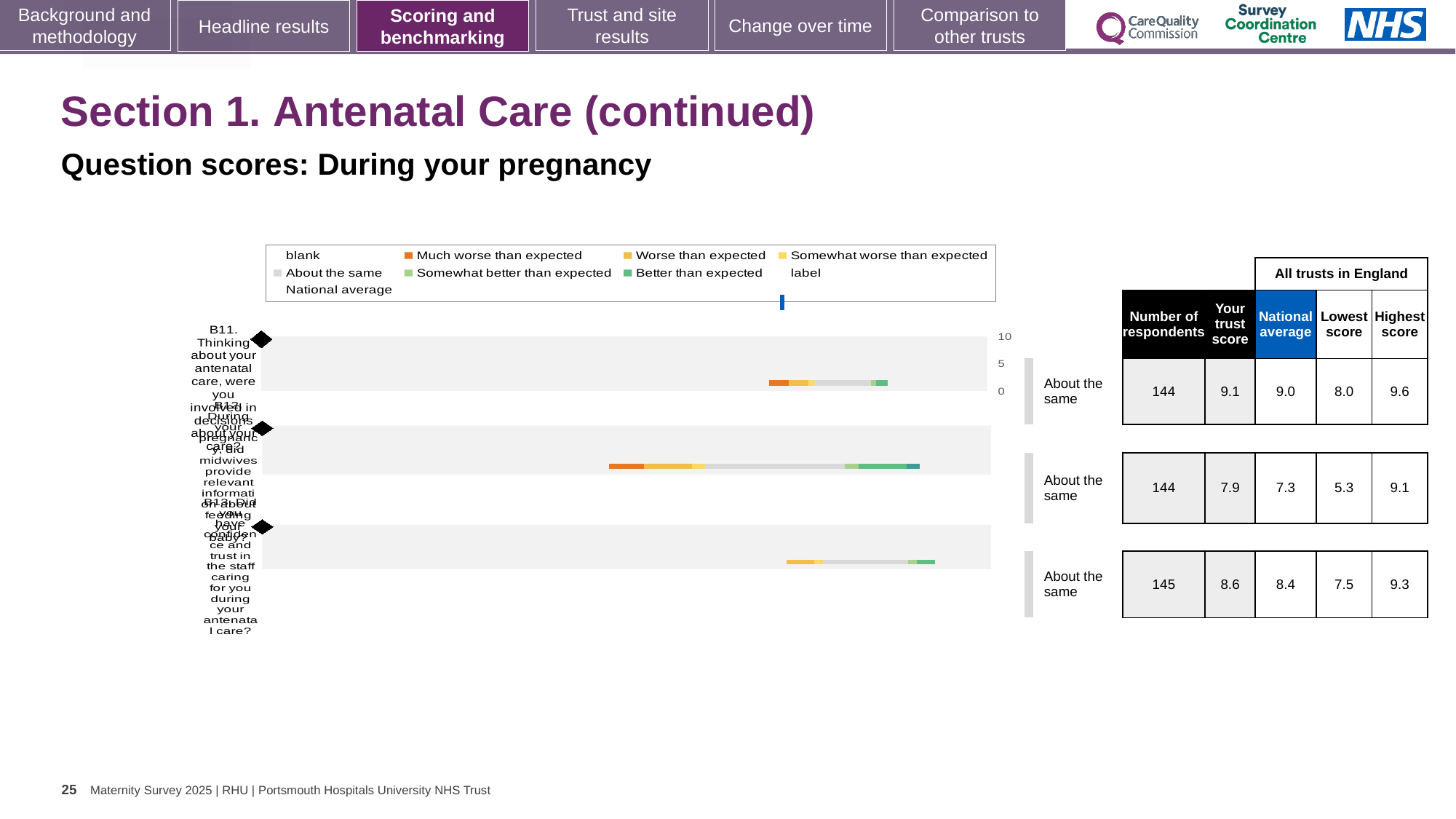
Which question has the lowest 'Your trust score'? B12 What kind of chart is shown on the slide? bar chart How many question rows (bars) does the chart show? 3 What benchmark category is shown for question B13? About the same For question B12, what is the difference between the highest score and the lowest score across all trusts in England? 3.8 What is the highest score across all trusts in England for question B11? 9.6 How many respondents are listed for question B13 (confidence and trust in the staff caring for you)? 145 For question B11, which is larger: the trust score or the national average? the trust score (9.1) What is the national average for question B12 (midwives provide relevant information about feeding your baby)? 7.3 What is the 'Your trust score' for question B11 (involved in decisions about your care)? 9.1 Which question has the highest 'Your trust score'? B11 What is the lowest score across all trusts in England for question B12? 5.3